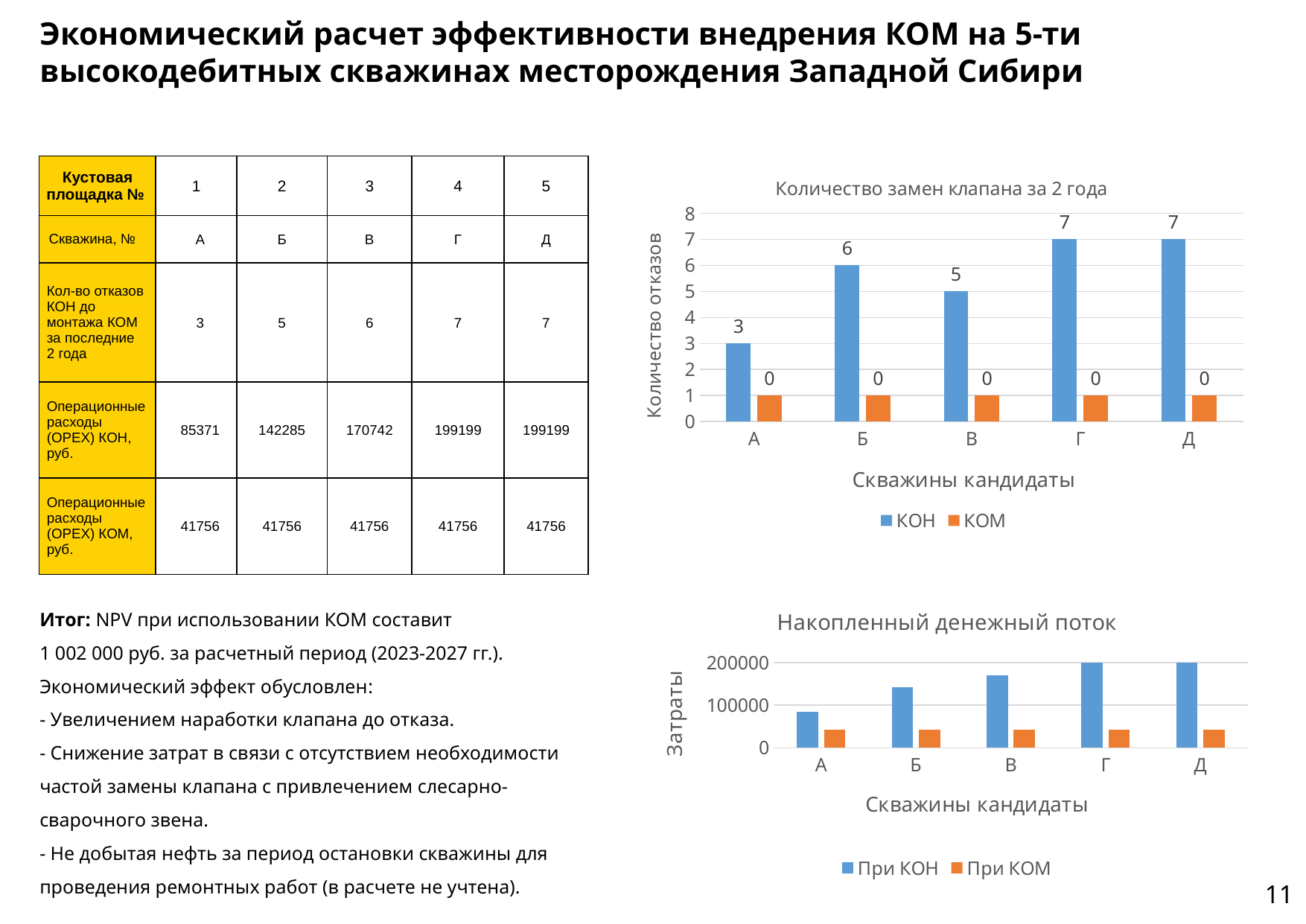
In the chart "Количество замен клапана за 2 года", what is the КОН value for well А? 3 In the chart "Количество замен клапана за 2 года", which well has the larger КОН value, Б or В? Б How many wells are shown on the x axis of the chart "Количество замен клапана за 2 года"? 5 How many series does the legend of the chart "Количество замен клапана за 2 года" list? 2 What kind of chart is the chart titled "Накопленный денежный поток"? bar chart In the chart "Количество замен клапана за 2 года", what is the difference between the КОН values for wells Б and В? 1 What are the legend entries of the chart "Накопленный денежный поток"? При КОН, При КОМ In the chart "Количество замен клапана за 2 года", what is the КОН value for well Б? 6 In the chart "Накопленный денежный поток", is the value of При КОН for well Г greater or less than 100000? greater In the chart "Количество замен клапана за 2 года", which well has the lowest КОН value? А What kind of chart is the chart titled "Количество замен клапана за 2 года"? bar chart In the chart "Накопленный денежный поток", is the value of При КОН for well А greater or less than 100000? less